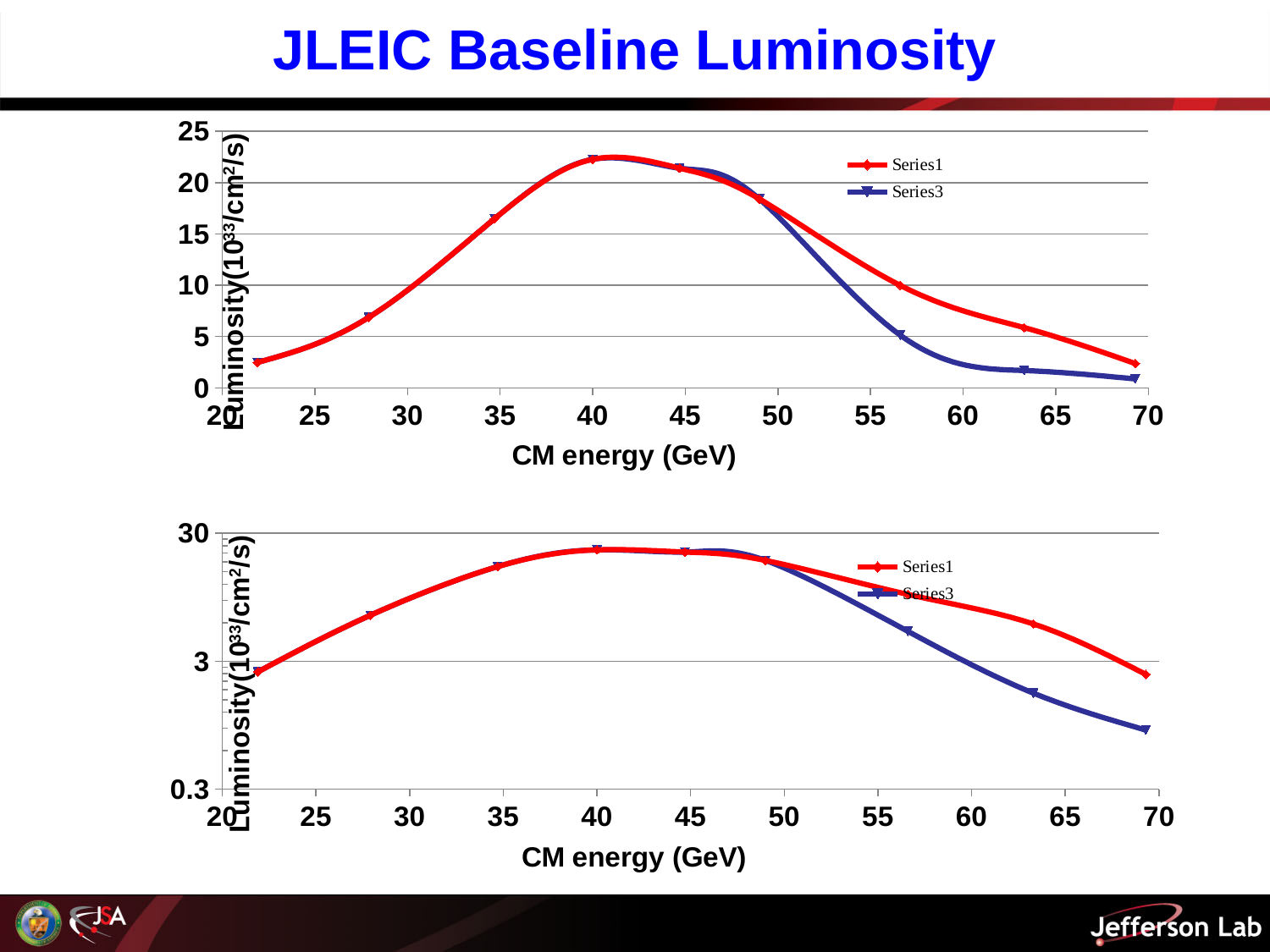
In the top chart, does Series3 rise or fall between 50 GeV and 70 GeV? fall What kind of chart is the top chart on the slide? line chart In the bottom chart, at 63 GeV, which series has the larger value, Series1 or Series3? Series1 In the bottom chart, is the value of Series3 at 69 GeV greater or less than 3? less In the top chart, is the value of Series3 at 63 GeV greater or less than 5? less In the top chart, is the value of Series1 at 28 GeV greater or less than 10? less What are the legend entries of the bottom chart? Series1 and Series3 How many series does the legend of the top chart list? 2 In the top chart, at 63 GeV, which series has the larger value, Series1 or Series3? Series1 What is the x-axis title of the top chart? CM energy (GeV)